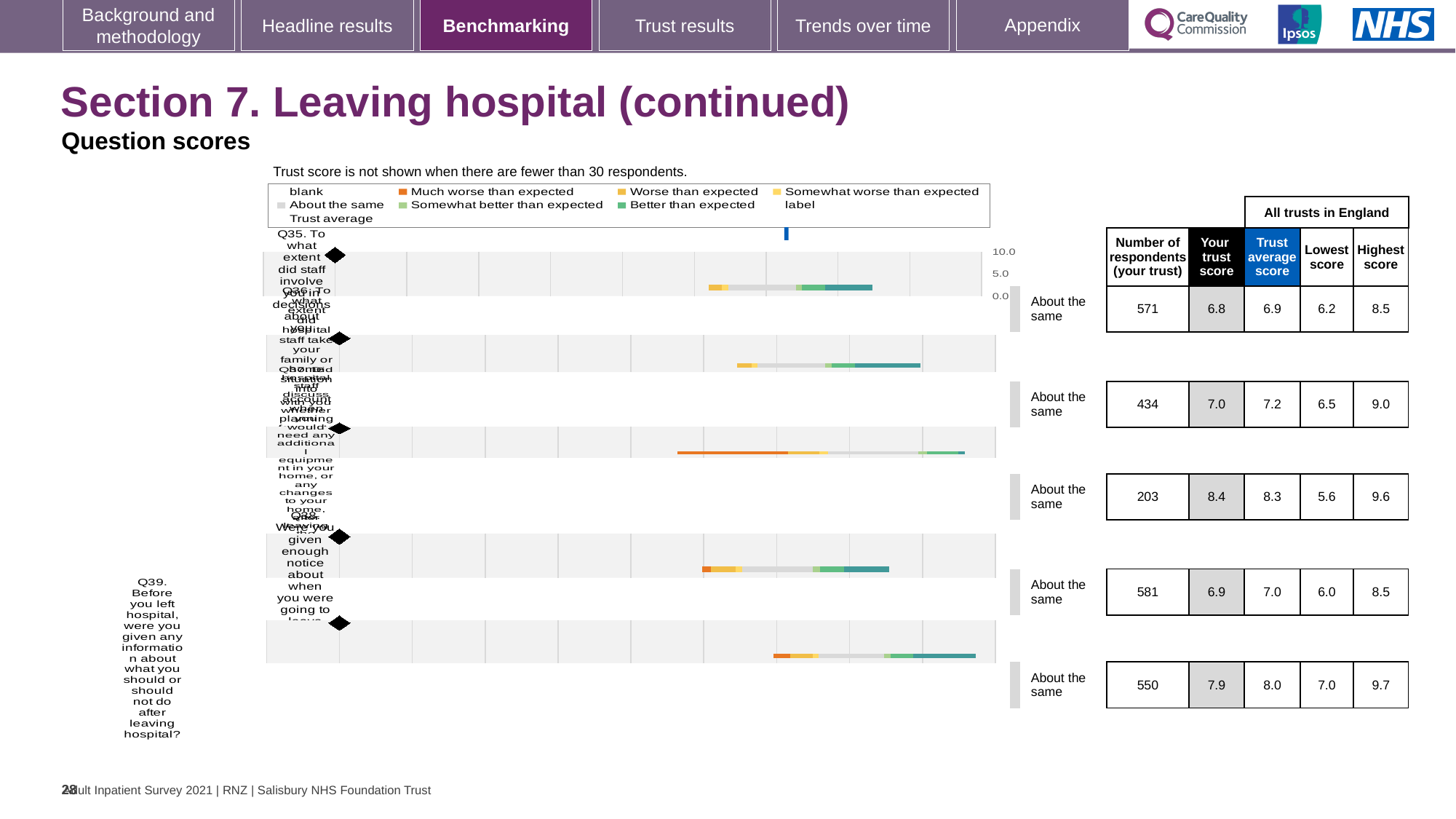
What is the 'Your trust score' for Q39 (information about what you should or should not do after leaving hospital)? 7.9 What colour represents 'Much worse than expected' in the chart legend? orange For Q39, is your trust score higher or lower than the trust average score? lower What type of chart is used to show the question scores on this slide? bar chart What is the trust average score for Q35 (staff involving you in decisions about leaving hospital)? 6.9 What benchmark category label is shown next to the Q39 row? About the same What is the highest 'Your trust score' shown in the table on this slide? 8.4 What is the difference between the highest score (9.7) and the lowest score (7.0) for Q39? 2.7 What is the smallest number of respondents shown for any question in the table? 203 What is the highest score across all trusts in England for Q39? 9.7 How many question rows are shown in the chart on this slide? 5 How many respondents from your trust answered Q39? 550